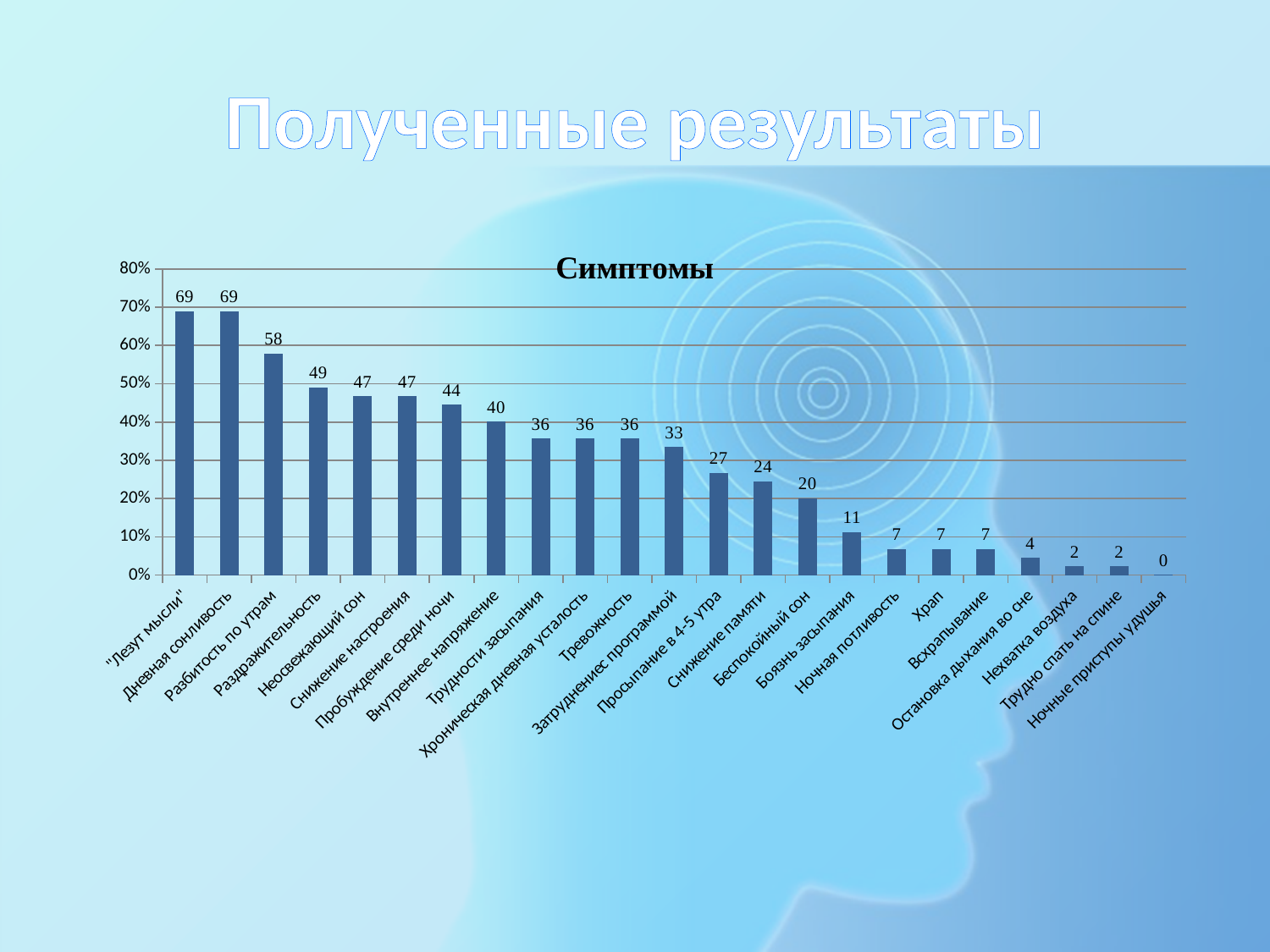
Which category has the lowest value? Ночные приступы удушья What is the value for Остановка дыхания во сне? 4 Do the values rise or fall from left to right along the x axis? Fall What is the title of the chart? Симптомы How many categories are shown on the chart? 23 What kind of chart is shown on the slide? Bar chart Is the value for Дневная сонливость greater or less than 60%? greater What is the difference between the values for Раздражительность and Снижение памяти? 25 Which is larger, the value for Внутреннее напряжение or the value for Просыпание в 4-5 утра? Внутреннее напряжение What is the value for Боязнь засыпания? 11 What is the value for Разбитость по утрам? 58 What is the value for Беспокойный сон? 20